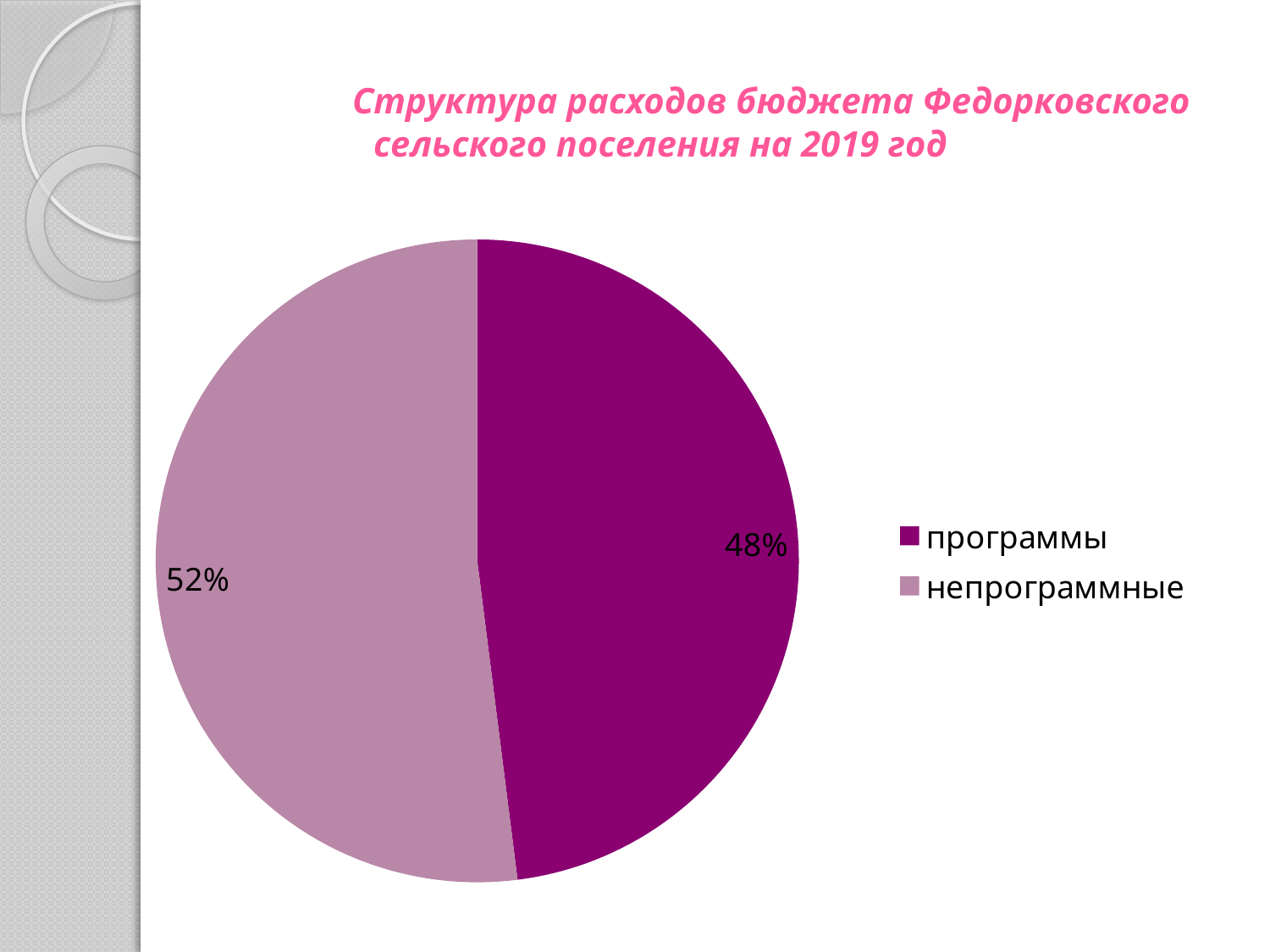
What kind of chart is shown on the slide? pie chart Is the share for программы greater or less than 50%? less What is the difference in percentage points between непрограммные and программы? 4% How many entries does the legend list? 2 What is the title of the chart on the slide? Структура расходов бюджета Федорковского сельского поселения на 2019 год Which legend entry is shown in the darker purple colour? программы Which category has the largest share of the pie? непрограммные How many slices does the pie chart have? 2 What share of the pie is labelled for непрограммные? 52% What share of the pie is labelled for программы? 48% Which is larger, the share for программы or the share for непрограммные? непрограммные Which category has the smallest share of the pie? программы